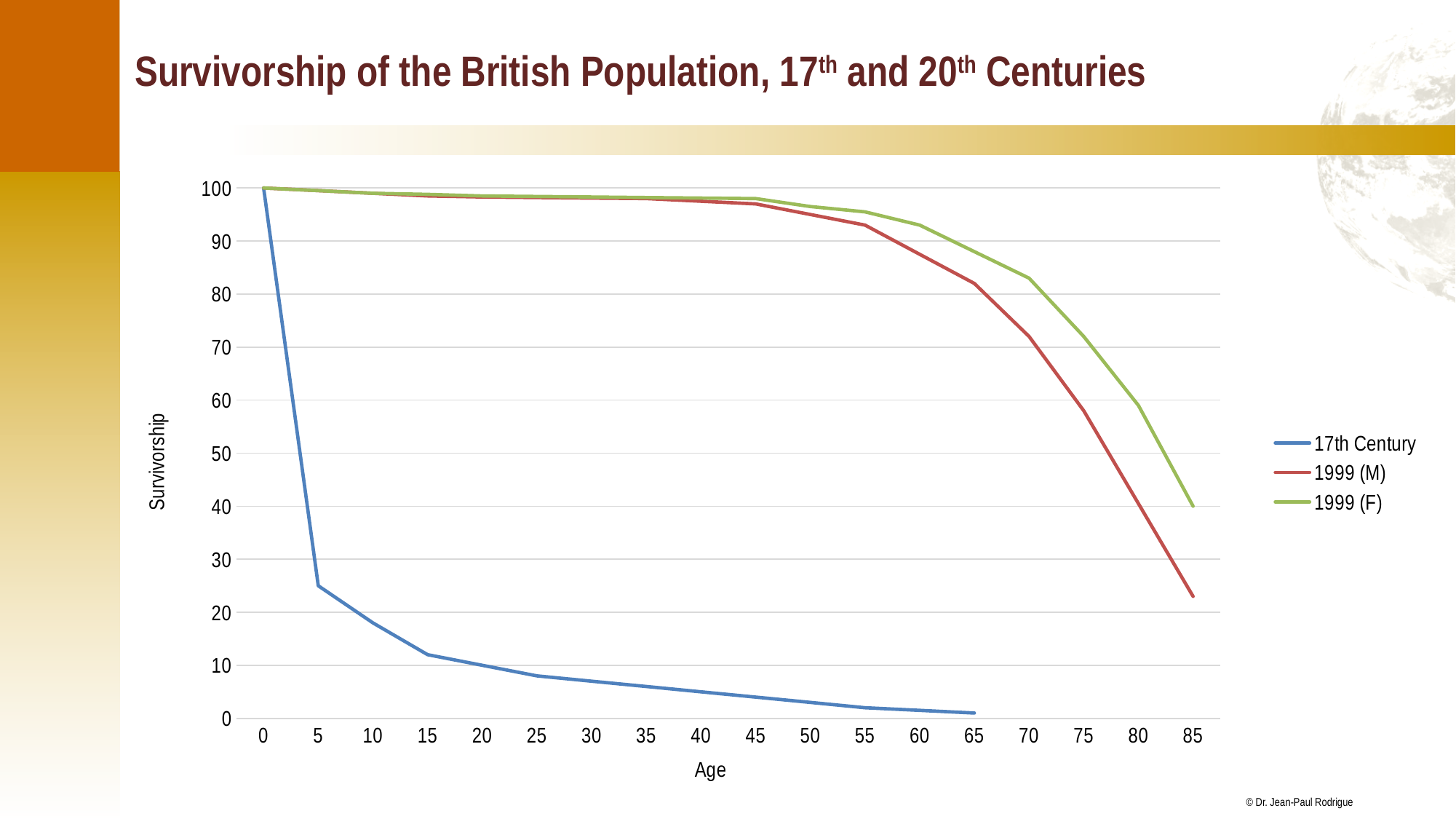
At age 5, which series has the higher survivorship, 17th Century or 1999 (M)? 1999 (M) Is the survivorship value for the 1999 (M) series at age 85 greater or less than 30? less What is the title of the chart? Survivorship of the British Population, 17th and 20th Centuries Is the survivorship value for the 17th Century series at age 5 greater or less than 30? less Is the survivorship value for the 17th Century series at age 15 greater or less than 20? less At age 85, which series has the higher survivorship, 1999 (M) or 1999 (F)? 1999 (F) What are the three series named in the legend? 17th Century, 1999 (M), 1999 (F) How many series does the legend list? 3 Does the 17th Century survivorship line rise or fall as age increases along the x axis? falls What kind of chart is shown on the slide? line chart